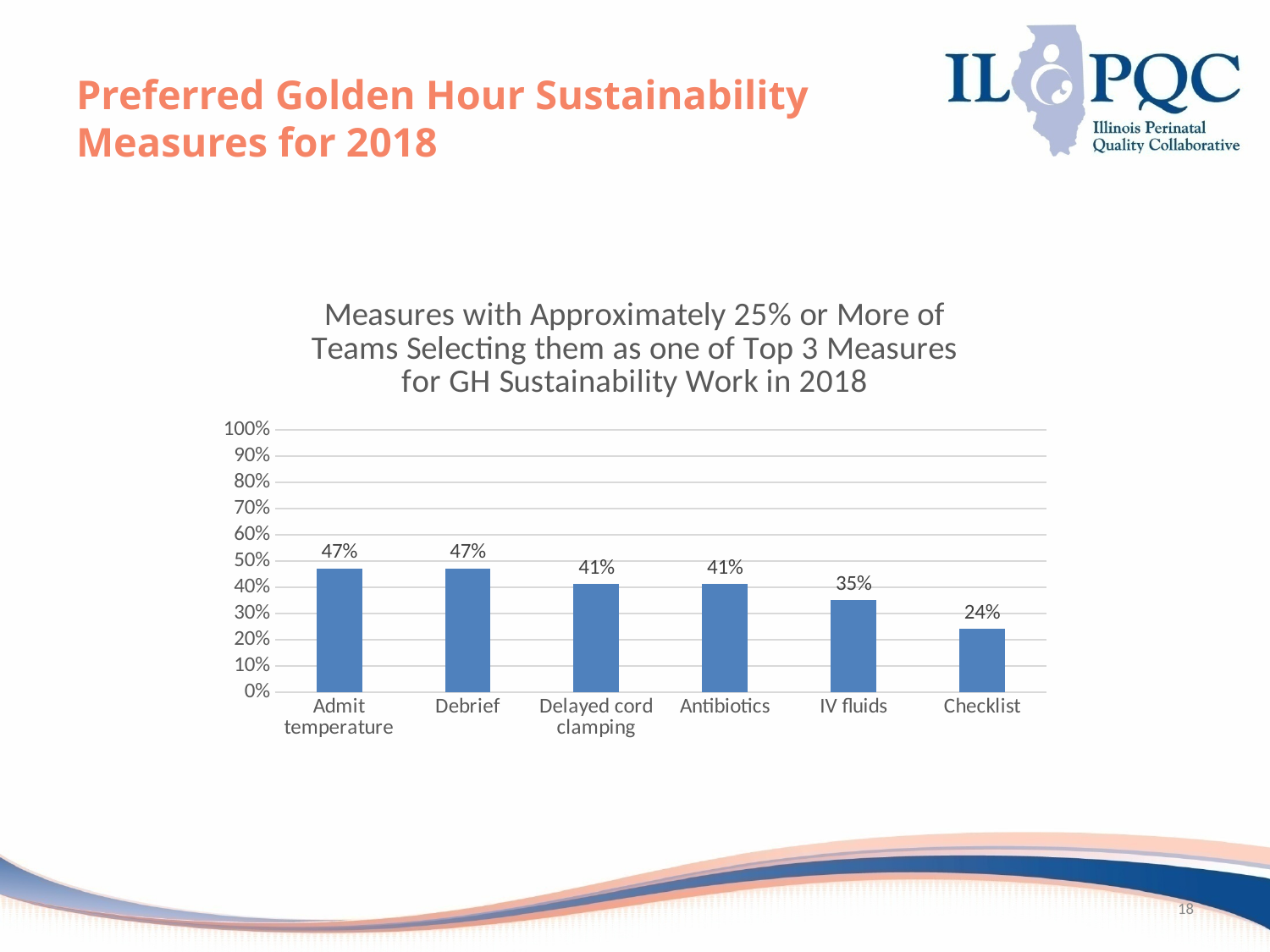
What is the highest value shown on the vertical axis? 100% What is the value shown for Checklist? 24% What is the value shown for Antibiotics? 41% What percentage of teams selected Admit temperature as one of their top 3 measures? 47% Do the values rise or fall moving from left to right across the chart? Fall Which is larger, the value for IV fluids or the value for Checklist? IV fluids Which measure has the lowest percentage of teams selecting it? Checklist What is the difference between the values for Debrief and Checklist? 23% How many measures are shown on the chart? 6 What is the difference between the values for Delayed cord clamping and IV fluids? 6% What is the value shown for IV fluids? 35% What kind of chart is shown on the slide? Bar chart